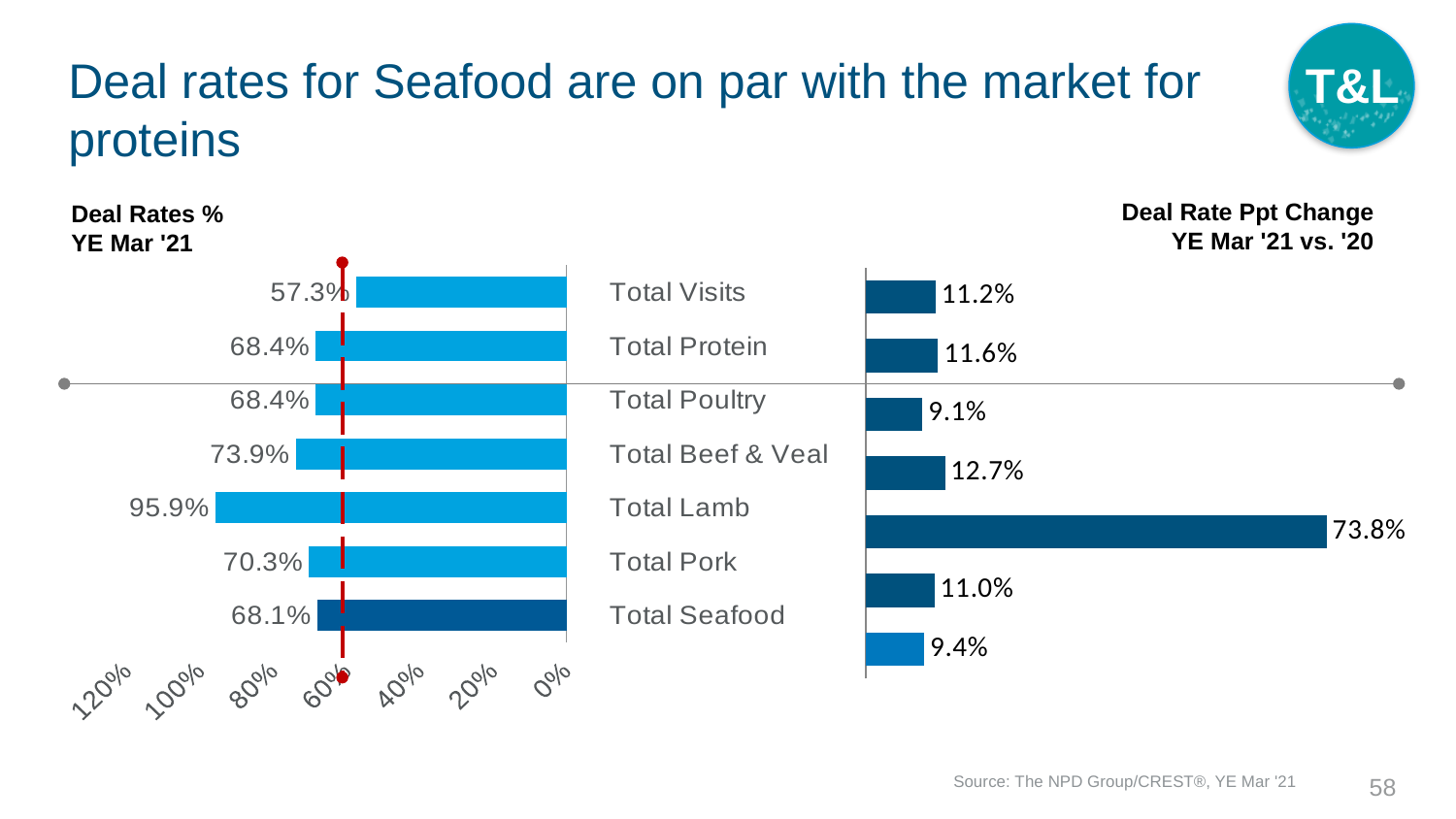
How many categories are shown in the Deal Rates % YE Mar '21 chart? 7 In the Deal Rates % YE Mar '21 chart, which is larger, the deal rate for Total Pork or Total Seafood? Total Pork In the Deal Rates % YE Mar '21 chart, which category has the highest deal rate? Total Lamb In the Deal Rate Ppt Change YE Mar '21 vs. '20 chart, what is the value for Total Beef & Veal? 12.7% In the Deal Rate Ppt Change YE Mar '21 vs. '20 chart, what is the value for Total Seafood? 9.4% In the Deal Rates % YE Mar '21 chart, what is the deal rate for Total Lamb? 95.9% In the Deal Rates % YE Mar '21 chart, what is the deal rate for Total Seafood? 68.1% What type of chart is the Deal Rate Ppt Change YE Mar '21 vs. '20 chart? Bar chart In the Deal Rate Ppt Change YE Mar '21 vs. '20 chart, which category has the smallest change? Total Poultry In the Deal Rates % YE Mar '21 chart, what is the difference between the deal rates for Total Lamb and Total Seafood? 27.8% In the Deal Rates % YE Mar '21 chart, which category has the lowest deal rate? Total Visits In the Deal Rate Ppt Change YE Mar '21 vs. '20 chart, what is the difference between the values for Total Protein and Total Seafood? 2.2%